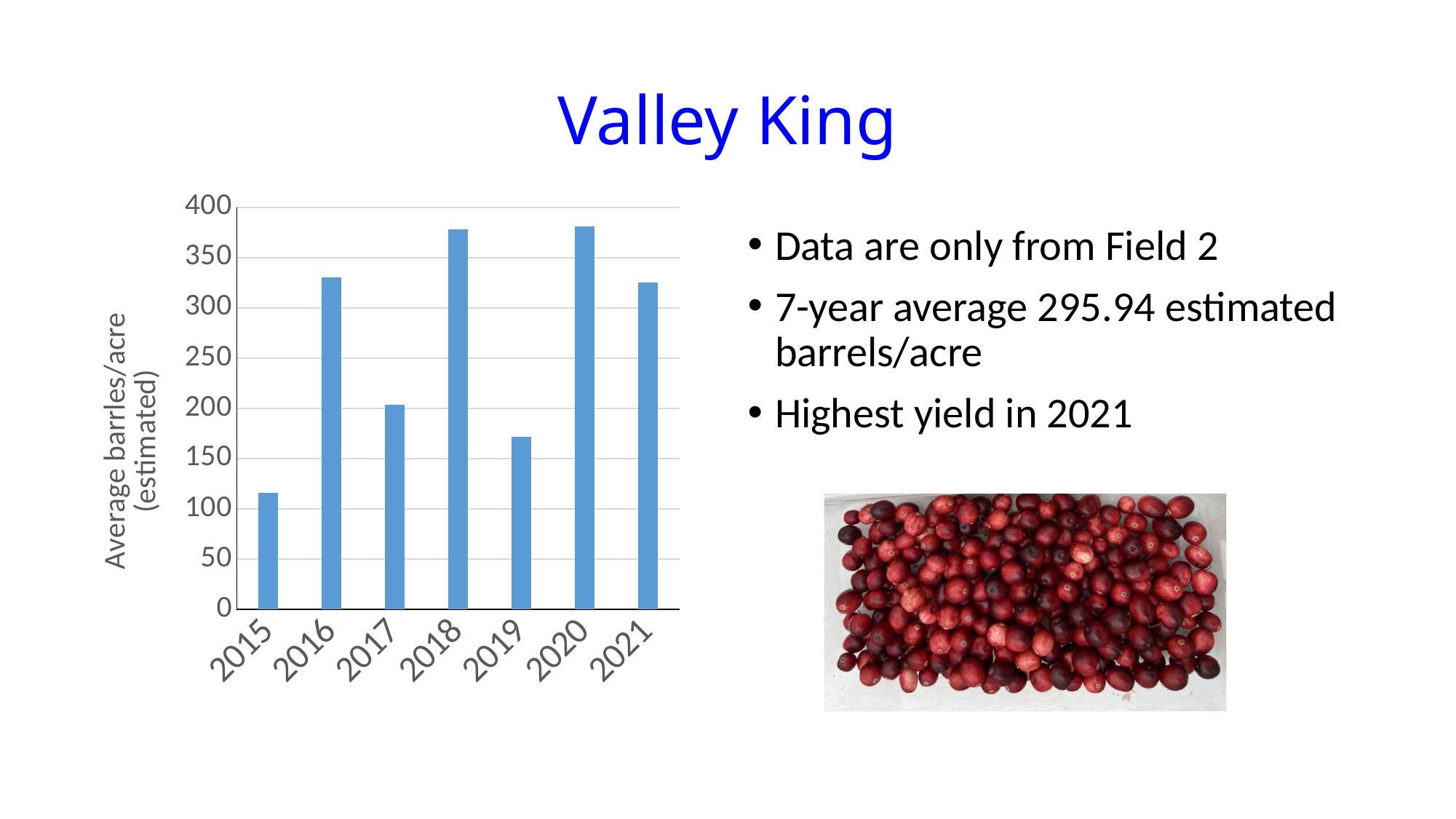
Does the value rise or fall from 2018 to 2019? fall Is the value for 2018 greater or less than 350? greater Is the value for 2016 greater or less than 300? greater What kind of chart is shown on the slide? bar chart Which year has the lowest average barrels/acre? 2015 Is the value for 2015 greater or less than 150? less How many years are plotted on the chart? 7 Which year has the larger value, 2017 or 2019? 2017 What is the label on the vertical axis of the chart? Average barrels/acre (estimated)